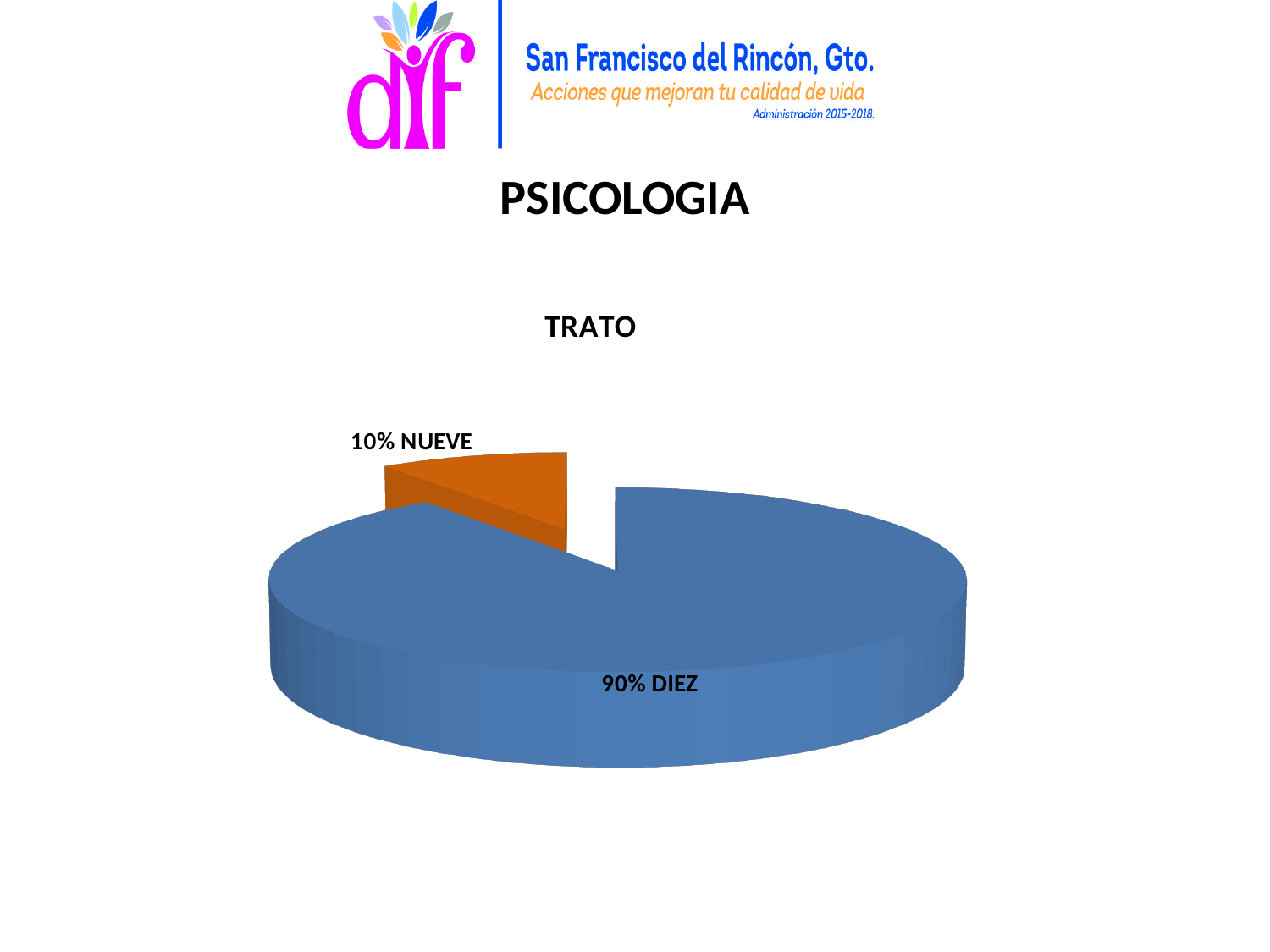
What percentage share does the NUEVE slice have? 10% What colour is the NUEVE slice? orange Which slice is the largest in the pie chart? DIEZ Which slice is the smallest in the pie chart? NUEVE How many slices does the pie chart have? 2 What is the difference in percentage points between the DIEZ and NUEVE slices? 80% What kind of chart is shown on the slide? pie chart Which slice is larger, DIEZ or NUEVE? DIEZ What is the title of the chart? TRATO What percentage share does the DIEZ slice have? 90%